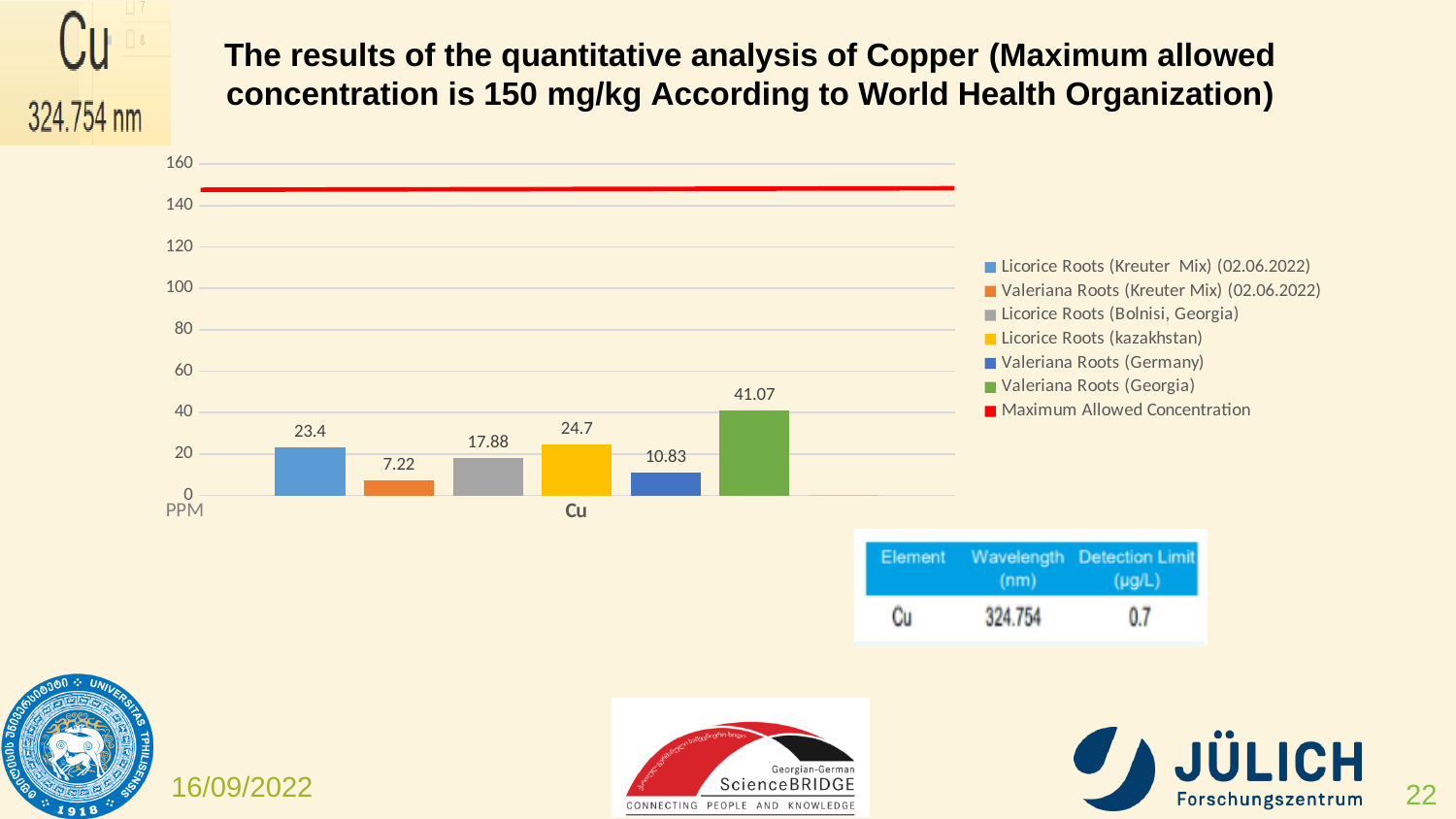
Which series has the highest value? Valeriana Roots (Georgia) How many entries does the legend list? 7 What is the value for Valeriana Roots (Kreuter Mix) (02.06.2022)? 7.22 Is the Maximum Allowed Concentration line greater or less than 140? greater Which series has the lowest value? Valeriana Roots (Kreuter Mix) (02.06.2022) What is the difference between Valeriana Roots (Georgia) and Licorice Roots (kazakhstan)? 16.37 What is the value for Licorice Roots (Kreuter Mix) (02.06.2022)? 23.4 What is the value for Licorice Roots (kazakhstan)? 24.7 What is the value for Valeriana Roots (Germany)? 10.83 What is the value for Licorice Roots (Bolnisi, Georgia)? 17.88 Which is larger, Licorice Roots (Bolnisi, Georgia) or Valeriana Roots (Germany)? Licorice Roots (Bolnisi, Georgia) What kind of chart is shown? bar chart